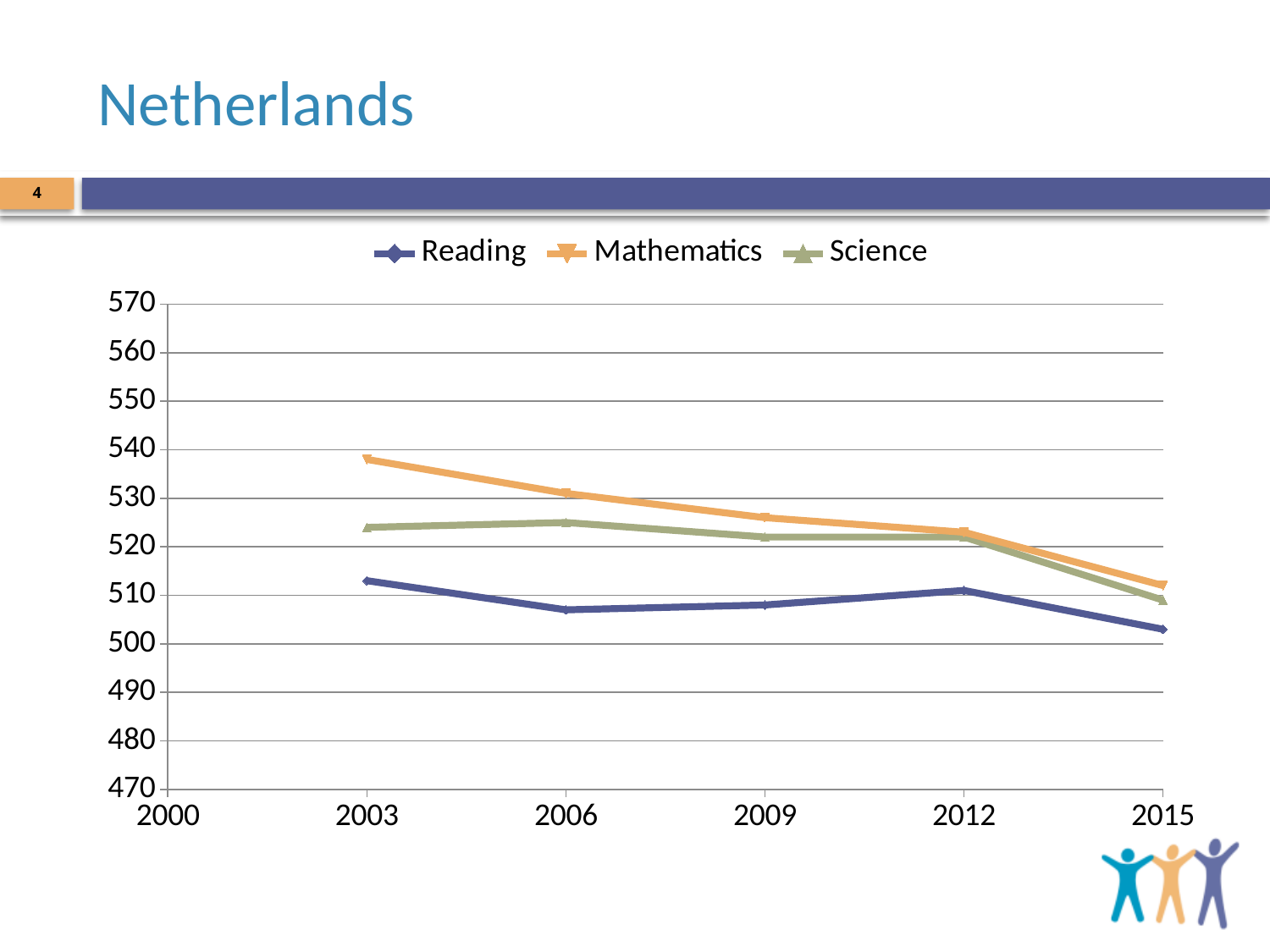
Is the value for Mathematics in 2009 greater or less than 530? less What kind of chart is shown on the slide? line chart Which is larger in 2012, the value for Reading or the value for Science? Science Is the value for Reading in 2006 greater or less than 510? less Is the value for Mathematics in 2003 greater or less than 530? greater Which series has the highest value in 2003? Mathematics How many series does the legend list? 3 Which series has the lowest value in 2012? Reading What is the title of the slide? Netherlands Does the Mathematics series rise or fall from 2003 to 2015? fall In which year does the Reading series reach its highest value? 2003